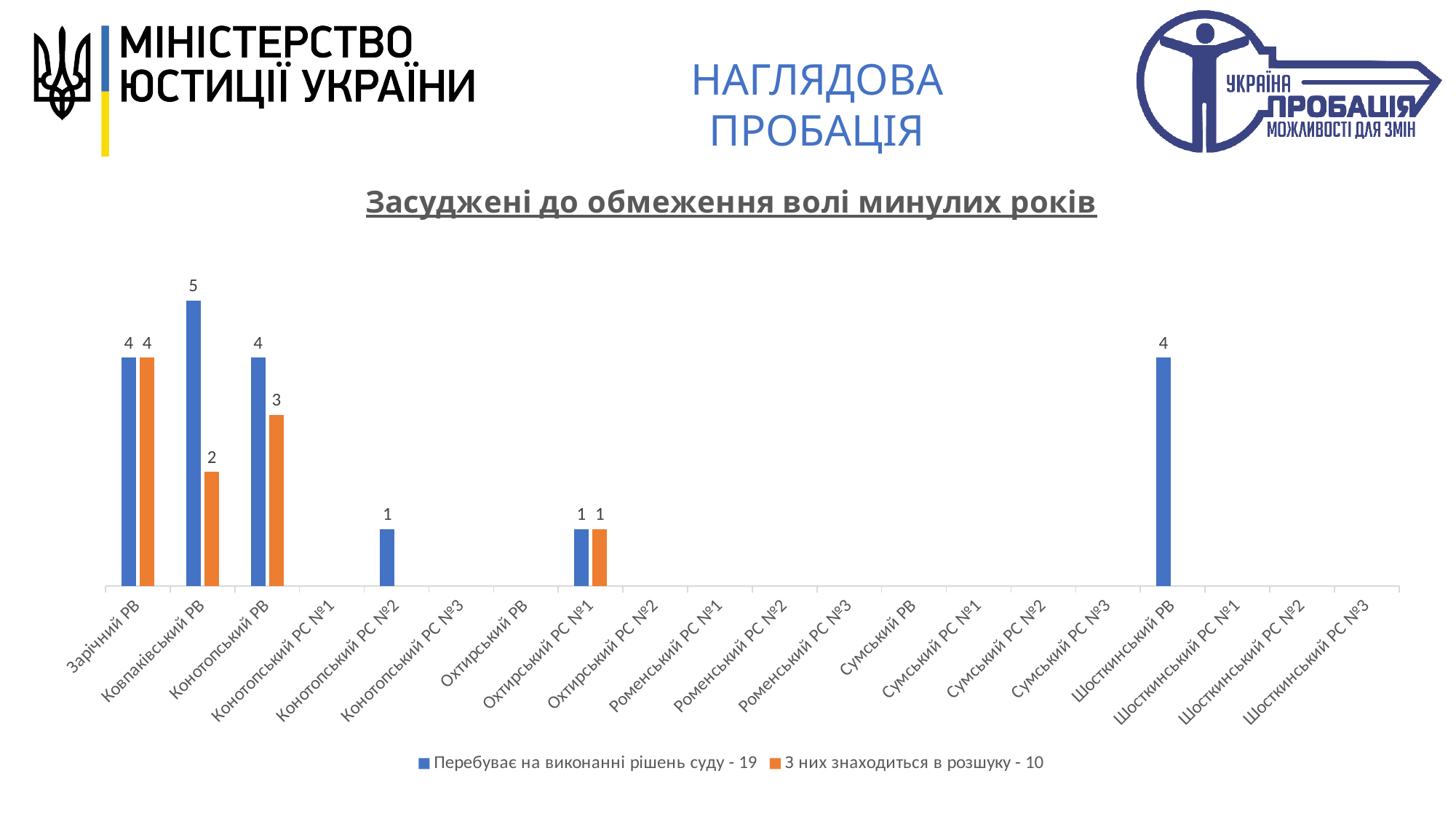
What type of chart is shown on the slide? bar chart What is the title of the chart? Засуджені до обмеження волі минулих років What is the difference between the two series values for Ковпаківський РВ? 3 How many series does the legend list? 2 What is the difference between the "Перебуває на виконанні рішень суду" values for Ковпаківський РВ and Конотопський РВ? 1 What is the value of "З них знаходиться в розшуку" for Конотопський РВ? 3 Which category has the highest value for "Перебуває на виконанні рішень суду"? Ковпаківський РВ Which is larger: the "З них знаходиться в розшуку" value for Зарічний РВ or for Конотопський РВ? Зарічний РВ What is the value of "Перебуває на виконанні рішень суду" for Шосткинський РВ? 4 What is the value of "Перебуває на виконанні рішень суду" for Ковпаківський РВ? 5 How many categories are shown on the x axis? 20 What is the value of "З них знаходиться в розшуку" for Ковпаківський РВ? 2